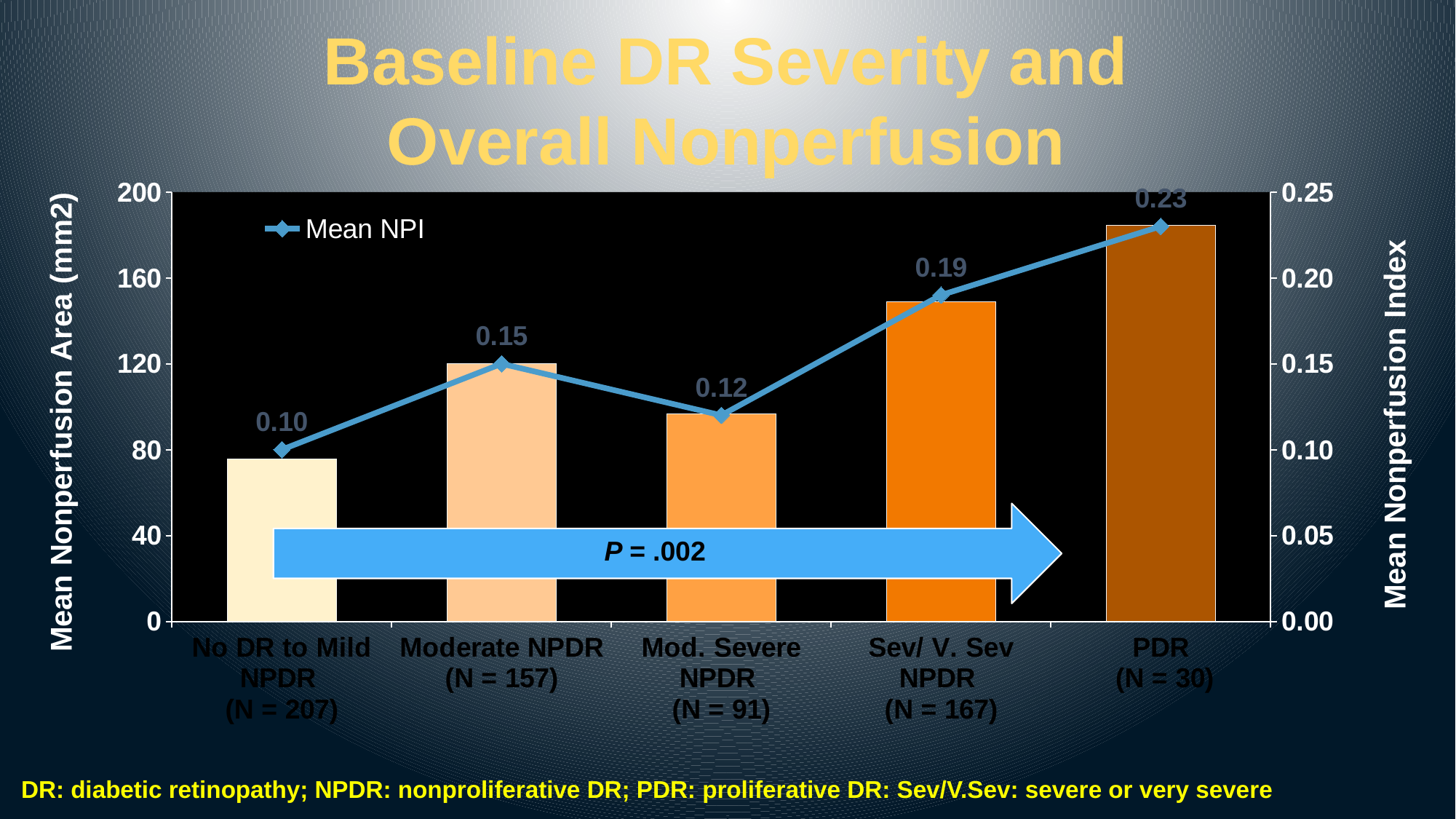
Is the Mean Nonperfusion Area bar for PDR greater or less than 160? greater What is the Mean NPI value for Moderate NPDR? 0.15 Which has a higher Mean NPI, Moderate NPDR or Mod. Severe NPDR? Moderate NPDR Which DR severity group has the highest Mean NPI? PDR Is the Mean Nonperfusion Area bar for No DR to Mild NPDR greater or less than 80? less What kind of chart is shown on the slide? Bar chart with a line overlay What P value is shown on the chart? P = .002 Which DR severity group has the lowest Mean NPI? No DR to Mild NPDR What is the Mean NPI value for Mod. Severe NPDR? 0.12 What is the difference in Mean NPI between PDR and No DR to Mild NPDR? 0.13 How many DR severity categories are shown on the x axis? 5 What is the Mean NPI value for the PDR group? 0.23